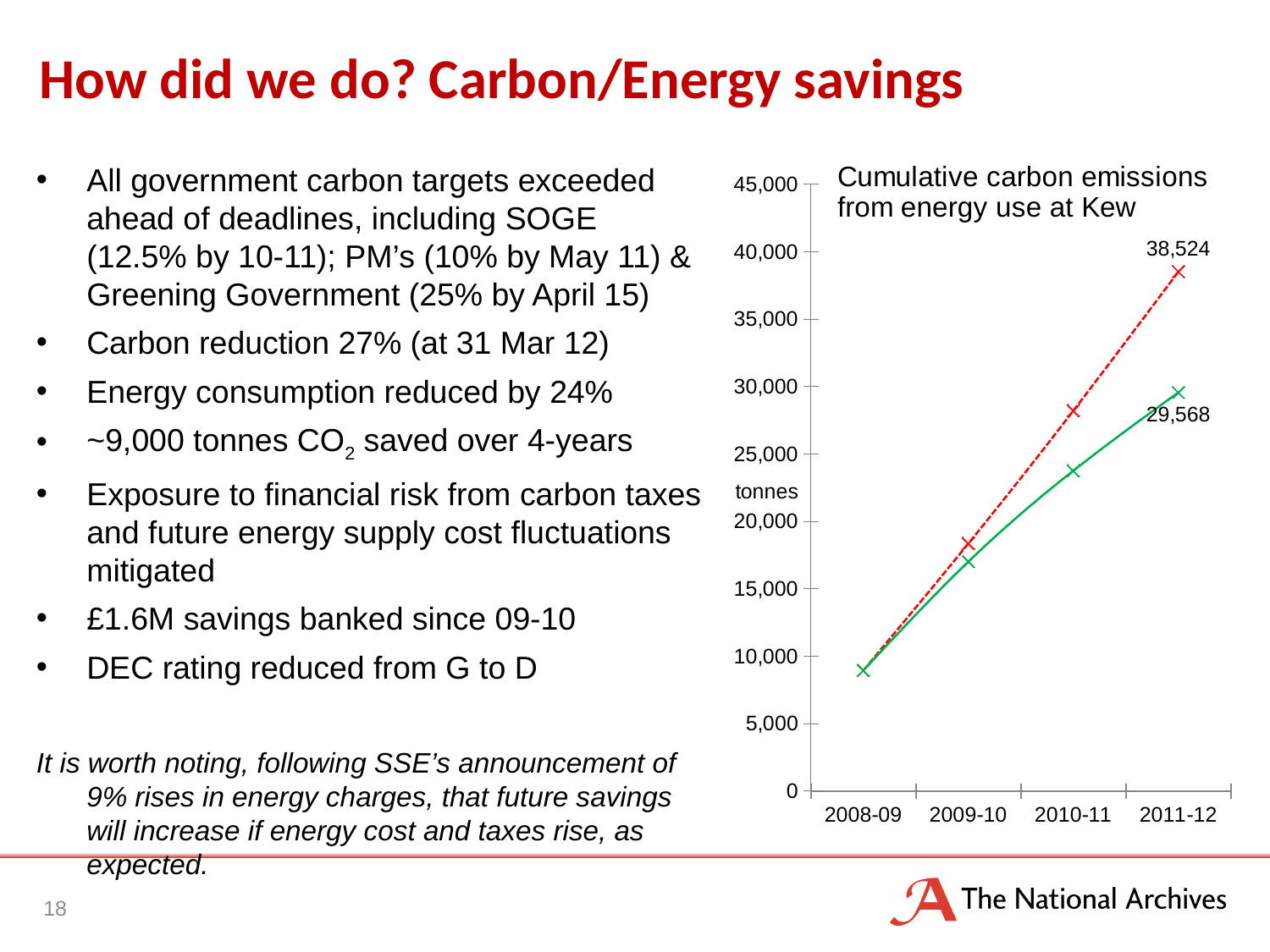
Is the value of the green solid line in 2010-11 greater or less than 25,000? less Is the value of the red dashed line in 2010-11 greater or less than 25,000? greater What unit is shown on the y axis of the chart? tonnes How many years are shown on the x axis? 4 Is the value in 2008-09 greater or less than 10,000? less Do the values of the lines rise or fall from 2008-09 to 2011-12? Rise What is the title of the chart? Cumulative carbon emissions from energy use at Kew What is the value of the red dashed line in 2011-12? 38,524 What is the difference between the red dashed line and the green solid line in 2011-12? 8,956 What type of chart is shown on the slide? Line chart In 2011-12, which line has the higher value, the red dashed line or the green solid line? The red dashed line What is the value of the green solid line in 2011-12? 29,568